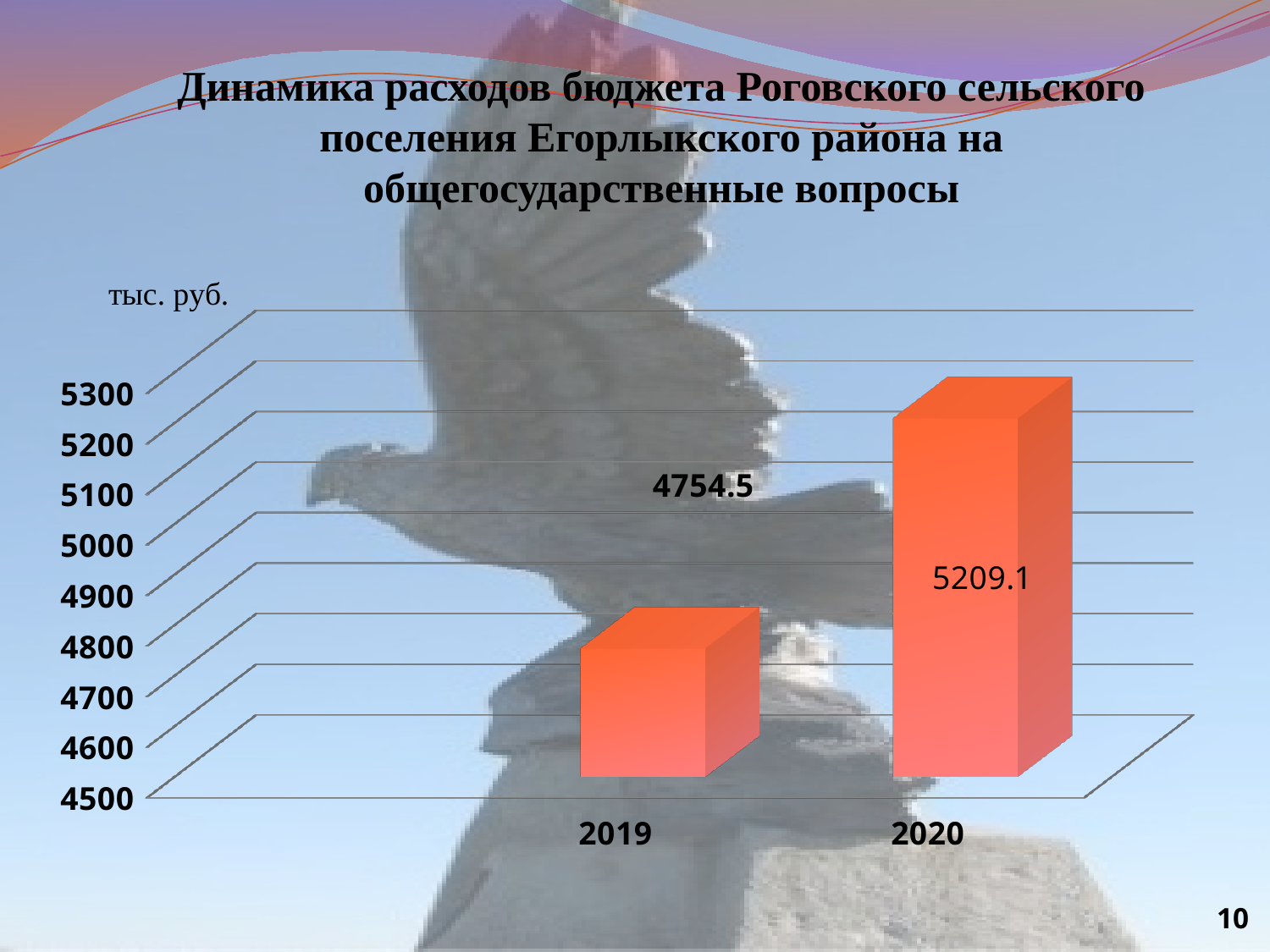
What is the value for 2020? 5209.1 How many years are shown on the chart? 2 Is the value for 2020 greater or less than 5100? greater What is the difference between the values for 2020 and 2019? 454.6 What is the value for 2019? 4754.5 Do the values rise or fall from 2019 to 2020? rise What kind of chart is shown on the slide? bar chart Which is larger, the value for 2019 or the value for 2020? 2020 Which year has the lowest value? 2019 What unit is indicated above the vertical axis of the chart? тыс. руб. Is the value for 2019 greater or less than 4800? less Which year has the highest value? 2020